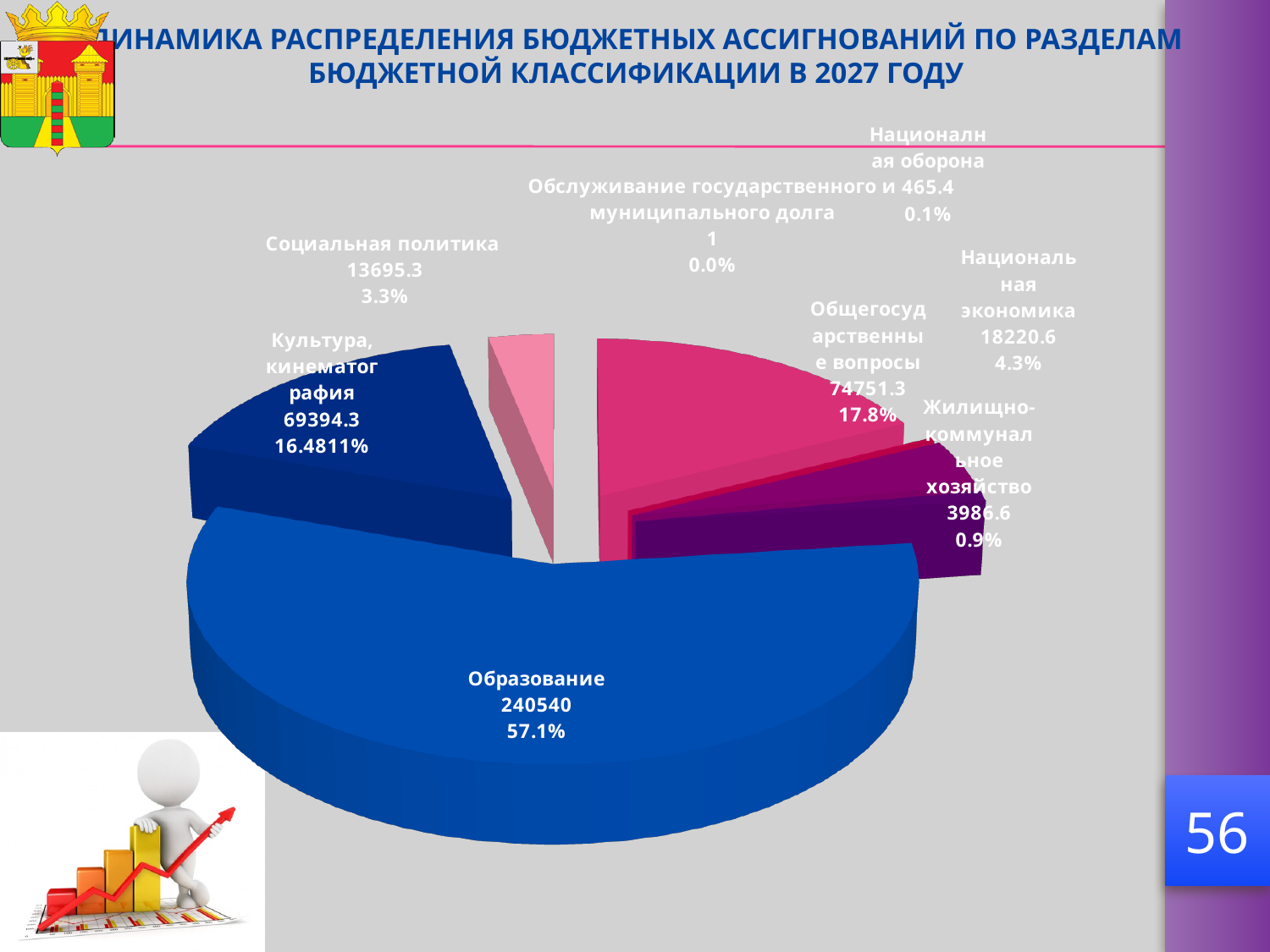
What is the difference between the values for Социальная политика and Жилищно-коммунальное хозяйство? 9708.7 Which is larger, the value for Общегосударственные вопросы or the value for Культура, кинематография? Общегосударственные вопросы What percentage is shown for Культура, кинематография? 16.4811% What is the value shown for Жилищно-коммунальное хозяйство? 3986.6 What is the value shown for Общегосударственные вопросы? 74751.3 Which category has the largest share of the pie? Образование How many categories are shown in the pie chart? 8 Which category has the smallest value in the pie? Обслуживание государственного и муниципального долга What is the value shown for Национальная экономика? 18220.6 What is the value shown for Образование? 240540 What kind of chart is shown on the slide? Pie chart What share of the pie does Образование represent? 57.1%